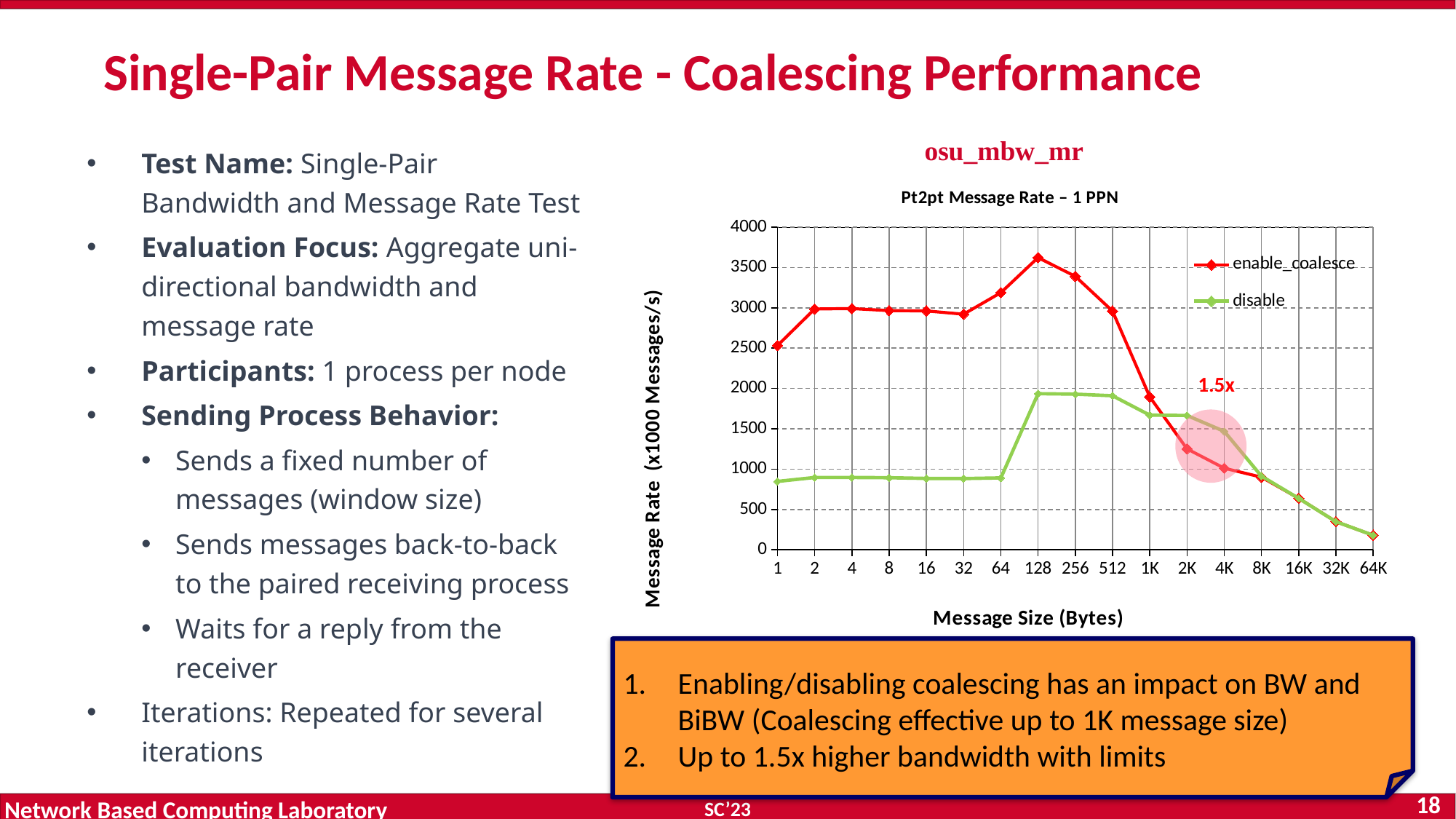
Is the disable value at message size 1 greater or less than 1000? less At message size 4K, which series has the higher message rate, enable_coalesce or disable? disable Is the enable_coalesce value at message size 128 greater or less than 3500? greater At which message size does the enable_coalesce series reach its highest message rate? 128 What is the label of the chart's x axis? Message Size (Bytes) Is the enable_coalesce value at message size 64K greater or less than 500? less How many message sizes are plotted along the x axis? 17 At which message size is the enable_coalesce series lowest? 64K Does the enable_coalesce series rise or fall from message size 1K to 64K? fall How many series does the chart legend list? 2 What kind of chart is shown on the slide? line chart